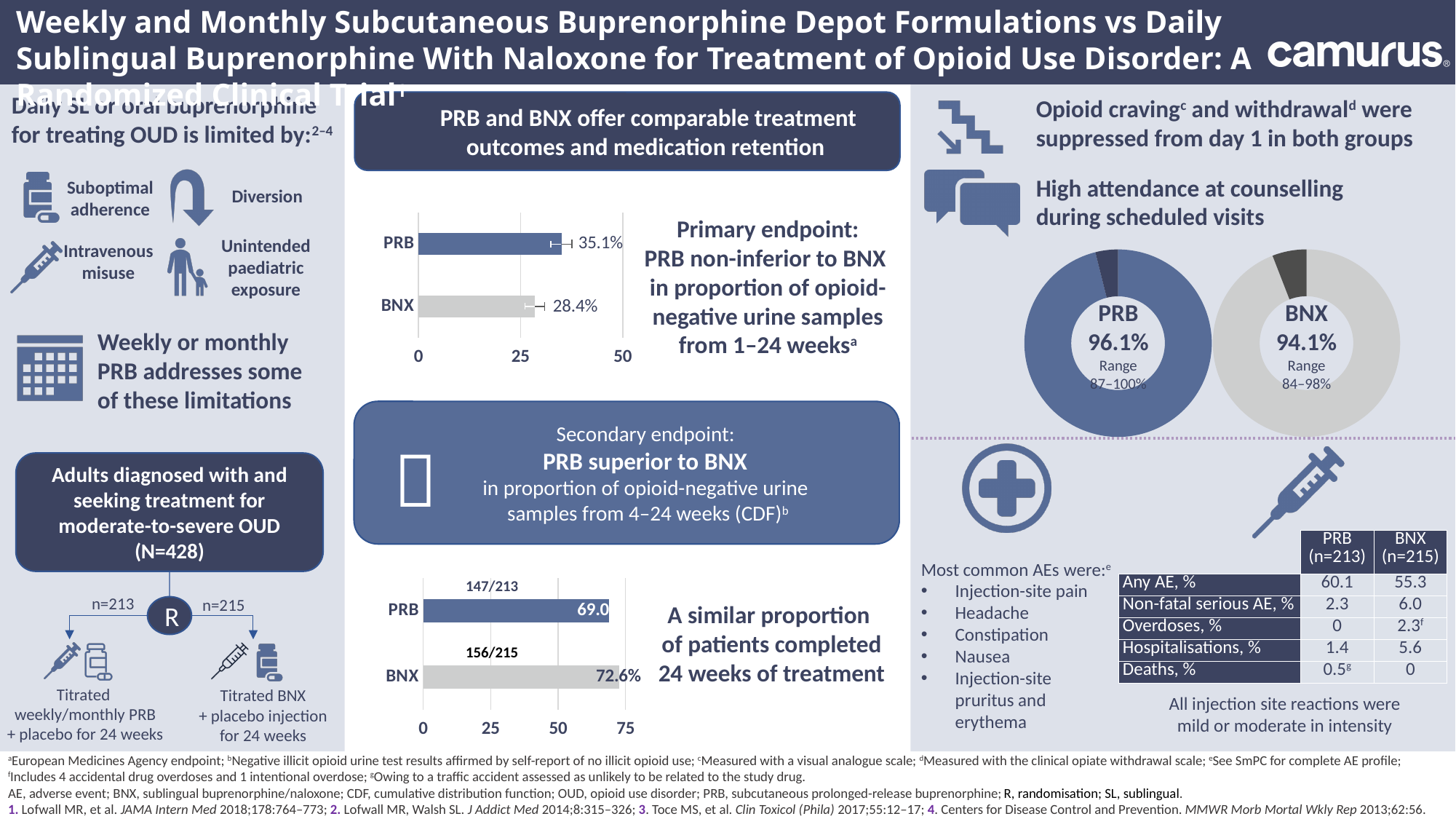
In the upper bar chart on the primary endpoint, which group has the higher proportion of opioid-negative urine samples? PRB What type of chart is used to show the proportion of patients completing 24 weeks of treatment? Bar chart In the lower bar chart on patients completing 24 weeks of treatment, what percentage of BNX patients completed treatment? 72.6% In the lower bar chart on patients completing 24 weeks of treatment, which group had the higher completion percentage? BNX In the donut charts on counselling attendance, what is the attendance value for PRB? 96.1% In the donut charts on counselling attendance, what range is shown for BNX? 84–98% In the lower bar chart on patients completing 24 weeks of treatment, what percentage of PRB patients completed treatment? 69.0 In the upper bar chart on the primary endpoint, what is the difference between the PRB and BNX values? 6.7% In the upper bar chart on the primary endpoint (opioid-negative urine samples from 1–24 weeks), what is the value for BNX? 28.4% In the upper bar chart on the primary endpoint, is the value for PRB greater or less than 25? greater In the upper bar chart on the primary endpoint (opioid-negative urine samples from 1–24 weeks), what is the value for PRB? 35.1% In the lower bar chart on patients completing 24 weeks of treatment, how many BNX patients completed treatment out of the total? 156/215